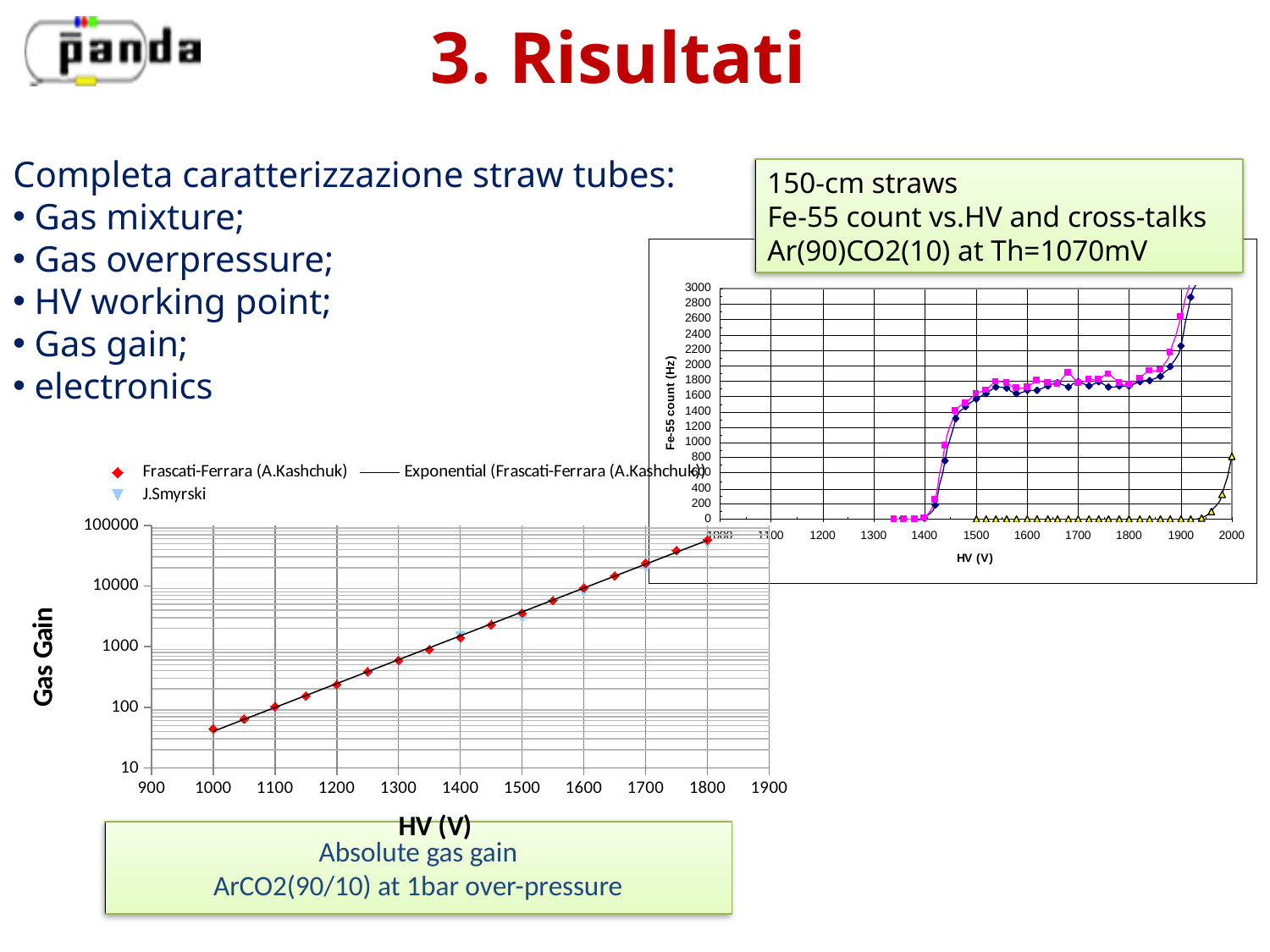
In the Fe-55 count vs. HV chart (top right), is the Fe-55 count at HV 1600 V greater or less than 1000? greater In the Absolute gas gain chart (bottom left), is the gas gain at HV 1500 V greater or less than 1000? greater In the Fe-55 count vs. HV chart (top right), does the Fe-55 count rise or fall as HV increases from 1400 V to 1500 V? rises In the Absolute gas gain chart (bottom left), how many entries does the legend list? 3 In the Absolute gas gain chart (bottom left), what is the label on the vertical axis? Gas Gain In the Absolute gas gain chart (bottom left), is the gas gain at HV 1000 V greater or less than 100? less In the Absolute gas gain chart (bottom left), does the gas gain rise or fall as HV increases from 1000 V to 1800 V? rises In the Absolute gas gain chart (bottom left), what kind of chart is used to show Gas Gain versus HV? scatter chart (points with an exponential trendline) In the Fe-55 count vs. HV chart (top right), what is the label on the vertical axis? Fe-55 count (Hz) In the Absolute gas gain chart (bottom left), which HV has the larger gas gain, 1000 V or 1800 V? 1800 V